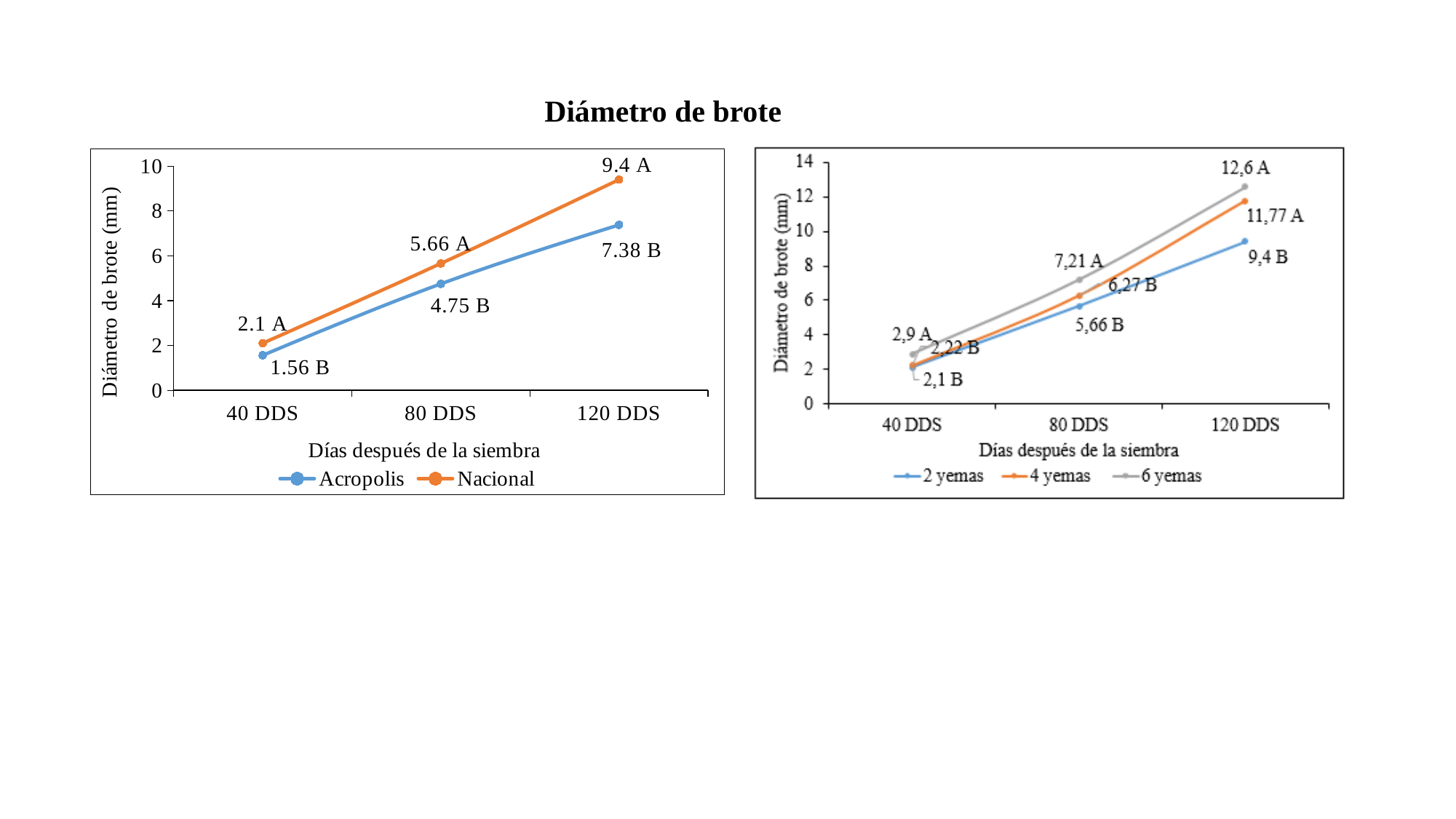
What kind of chart is the right chart? line chart In the right chart, what is the value for 4 yemas at 80 DDS? 6,27 In the left chart, what is the difference between Nacional and Acropolis at 120 DDS? 2.02 In the left chart, which series is higher at 80 DDS, Acropolis or Nacional? Nacional In the left chart, what is the value for Acropolis at 40 DDS? 1.56 In the right chart, what is the value for 6 yemas at 120 DDS? 12,6 In the left chart, do the values rise or fall from 40 DDS to 120 DDS? rise In the right chart, how many series does the legend list? 3 In the right chart, what is the difference between 6 yemas and 2 yemas at 120 DDS? 3,2 In the right chart, which series has the lowest value at 120 DDS? 2 yemas In the left chart, what is the value for Nacional at 120 DDS? 9.4 In the left chart, how many series does the legend list? 2